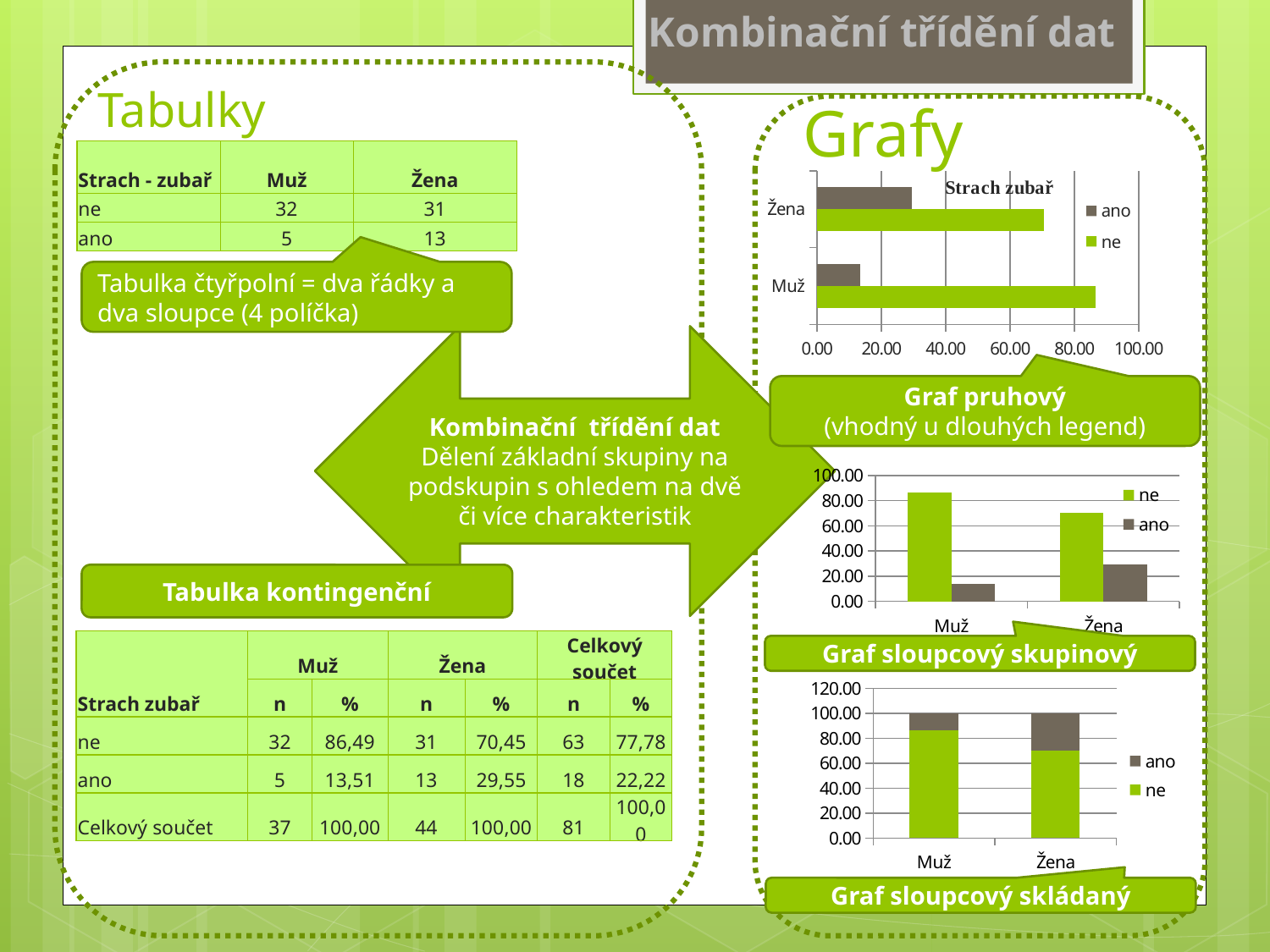
In the middle-right grouped bar chart (Graf sloupcový skupinový), is the "ano" value for Muž greater or less than 20.00? less In the middle-right grouped bar chart (Graf sloupcový skupinový), how many categories are shown on the x axis? 2 In the top-right chart titled "Strach zubař", is the value of "ano" for Žena greater or less than 40.00? less In the top-right chart titled "Strach zubař", which is larger for Žena: "ano" or "ne"? ne In the top-right chart titled "Strach zubař", which category has the lowest "ano" value? Muž In the top-right chart titled "Strach zubař", is the value of "ne" for Muž greater or less than 80.00? greater In the middle-right grouped bar chart (Graf sloupcový skupinový), which category has the highest "ne" value? Muž In the top-right chart titled "Strach zubař", how many series does the legend list? 2 In the top-right chart titled "Strach zubař", what kind of chart is it? bar chart In the bottom-right stacked bar chart (Graf sloupcový skládaný), which colour represents the "ne" series? green In the middle-right grouped bar chart (Graf sloupcový skupinový), which is larger: "ano" for Muž or "ano" for Žena? ano for Žena In the bottom-right stacked bar chart (Graf sloupcový skládaný), what is the total height of the Muž bar? 100.00